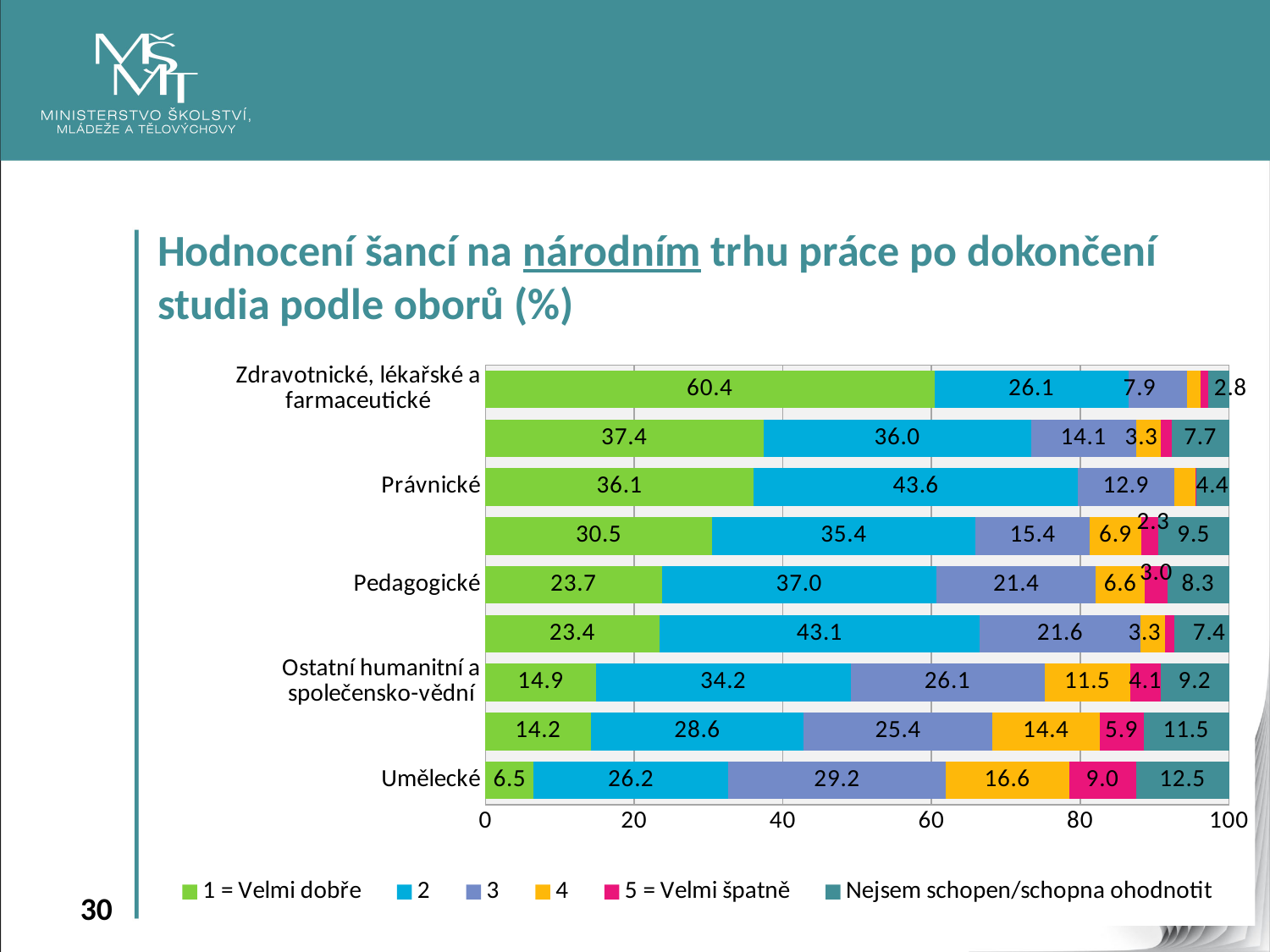
How many bars (fields of study) are plotted in the chart? 9 What is the value of series "4" for Ostatní humanitní a společensko-vědní? 11.5 What is the value of series "2" for Právnické? 43.6 What is the value of the "Nejsem schopen/schopna ohodnotit" segment for Umělecké? 12.5 What is the value of the "1 = Velmi dobře" segment for Zdravotnické, lékařské a farmaceutické? 60.4 Which field has the highest "1 = Velmi dobře" value? Zdravotnické, lékařské a farmaceutické How many series does the legend list? 6 What kind of chart is shown on the slide? Stacked bar chart What is the value of series "3" for Pedagogické? 21.4 Which field has the lowest "1 = Velmi dobře" value? Umělecké Which has a larger value for series "2": Ostatní humanitní a společensko-vědní or Umělecké? Ostatní humanitní a společensko-vědní What is the difference between the "5 = Velmi špatně" values for Umělecké and Pedagogické? 6.0